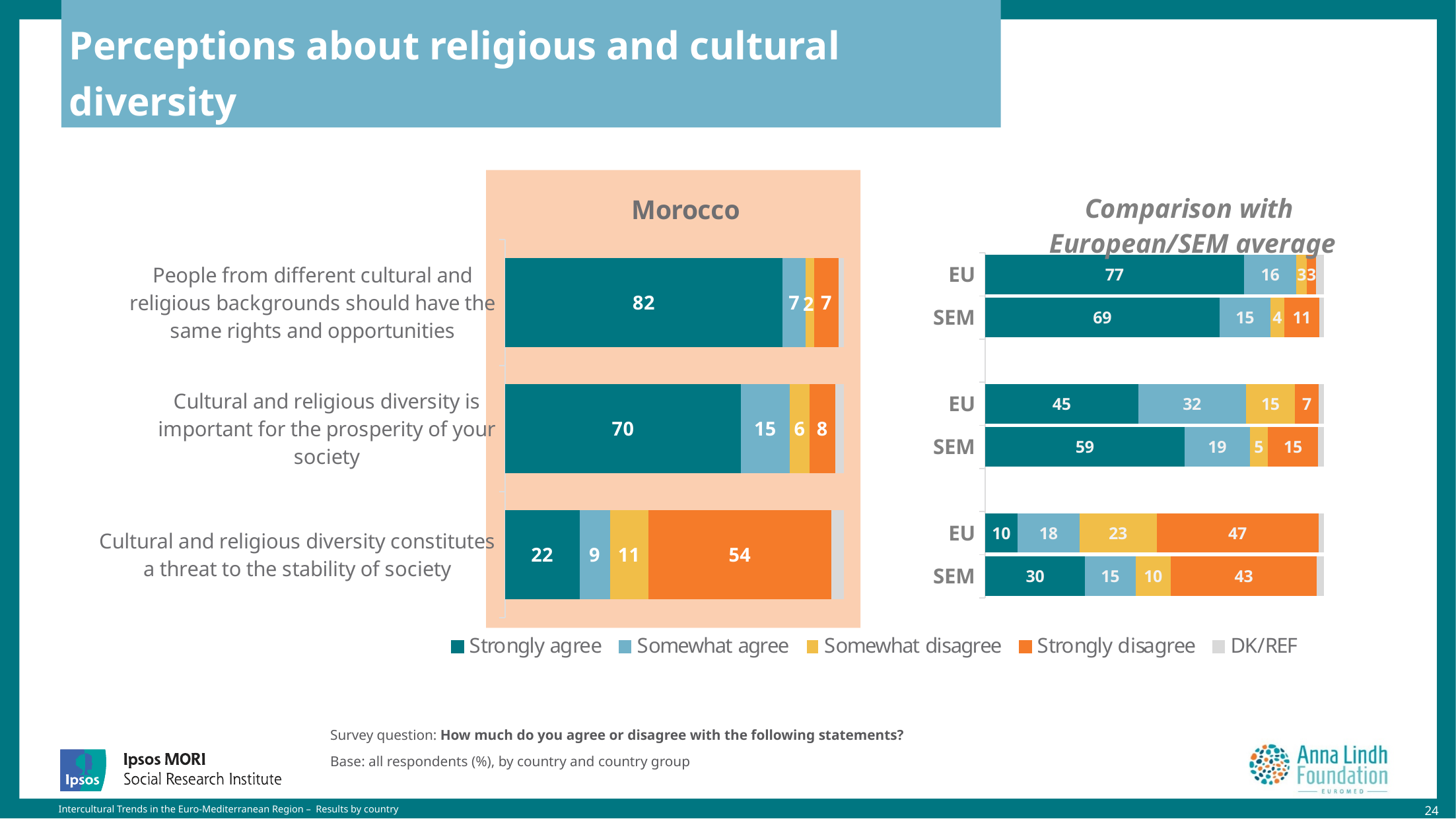
In the Comparison with European/SEM average chart, for the second statement (diversity is important for prosperity), which has the larger Strongly agree value, EU or SEM? SEM How many series does the legend list for the charts on this slide? 5 In the Comparison with European/SEM average chart, what is the SEM Strongly disagree value for the third statement (diversity constitutes a threat)? 43 In the Comparison with European/SEM average chart, what is the EU Somewhat agree value for the second statement (diversity is important for prosperity)? 32 In the Comparison with European/SEM average chart, what is the EU Strongly agree value for the first statement (same rights and opportunities)? 77 In the Morocco chart, what is the difference between the Strongly agree values for the 'same rights and opportunities' statement and the 'prosperity of your society' statement? 12 How many statements are shown in the Morocco chart? 3 In the Morocco chart, what percentage strongly disagree that cultural and religious diversity constitutes a threat to the stability of society? 54 In the Comparison with European/SEM average chart, what is the difference between the EU and SEM Strongly disagree values for the third statement (diversity constitutes a threat)? 4 In the Morocco chart, which statement has the highest Strongly agree value? People from different cultural and religious backgrounds should have the same rights and opportunities In the Morocco chart, what is the Somewhat agree value for the statement that cultural and religious diversity is important for the prosperity of your society? 15 In the Morocco chart, what percentage strongly agree that people from different cultural and religious backgrounds should have the same rights and opportunities? 82